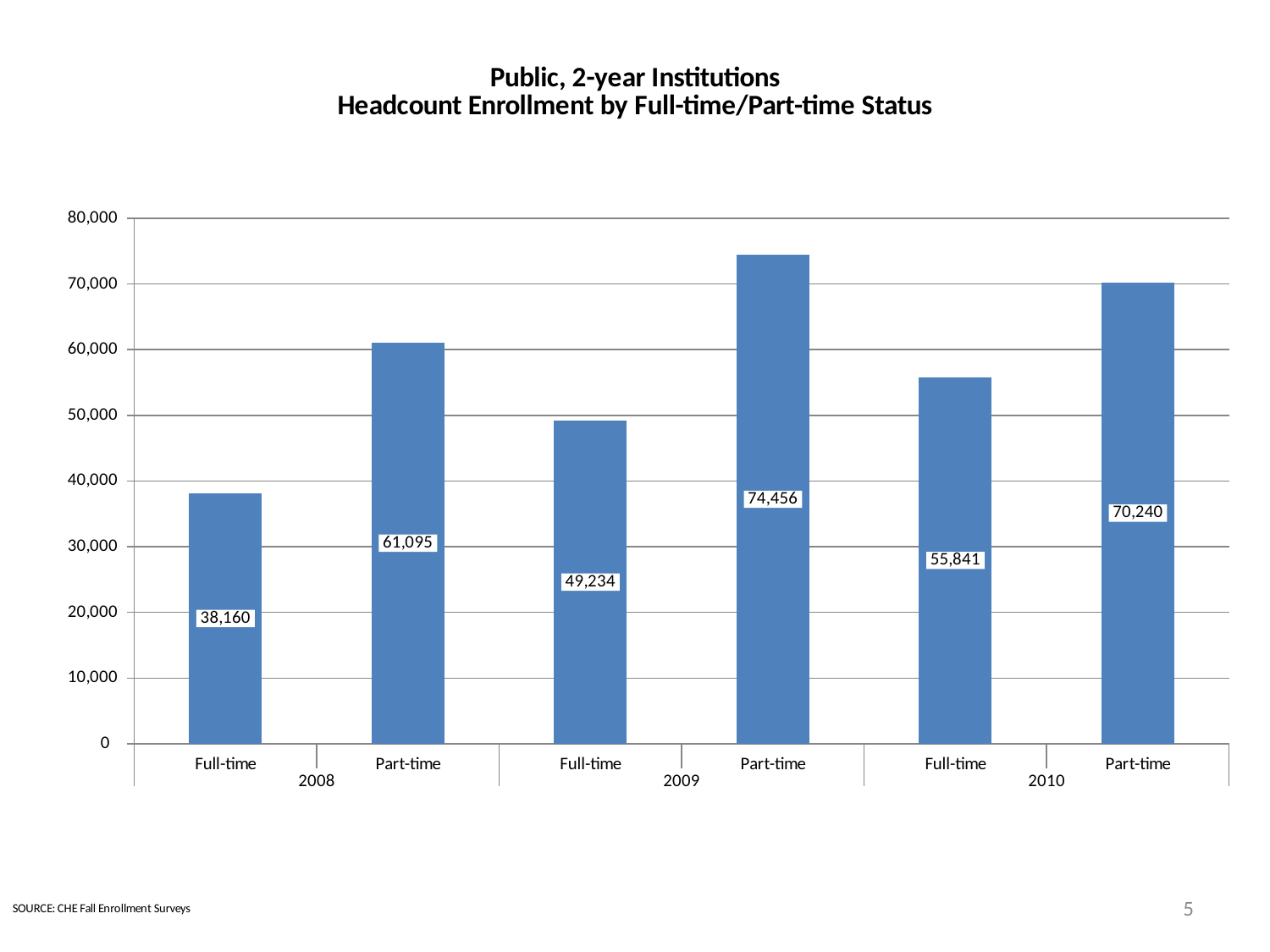
Which is larger, part-time enrollment in 2008 or part-time enrollment in 2010? Part-time 2010 What is the difference between full-time enrollment in 2009 and 2008? 11,074 What is the full-time headcount enrollment for 2010? 55,841 What kind of chart is shown on the slide? Bar chart What is the part-time headcount enrollment for 2009? 74,456 Which bar has the lowest value? Full-time 2008 How many bars are plotted on the chart? 6 What is the difference between part-time and full-time enrollment in 2010? 14,399 Is the full-time enrollment for 2009 greater or less than 40,000? greater What is the full-time headcount enrollment for 2008? 38,160 Which bar has the highest value? Part-time 2009 What is the source cited for the chart data? CHE Fall Enrollment Surveys